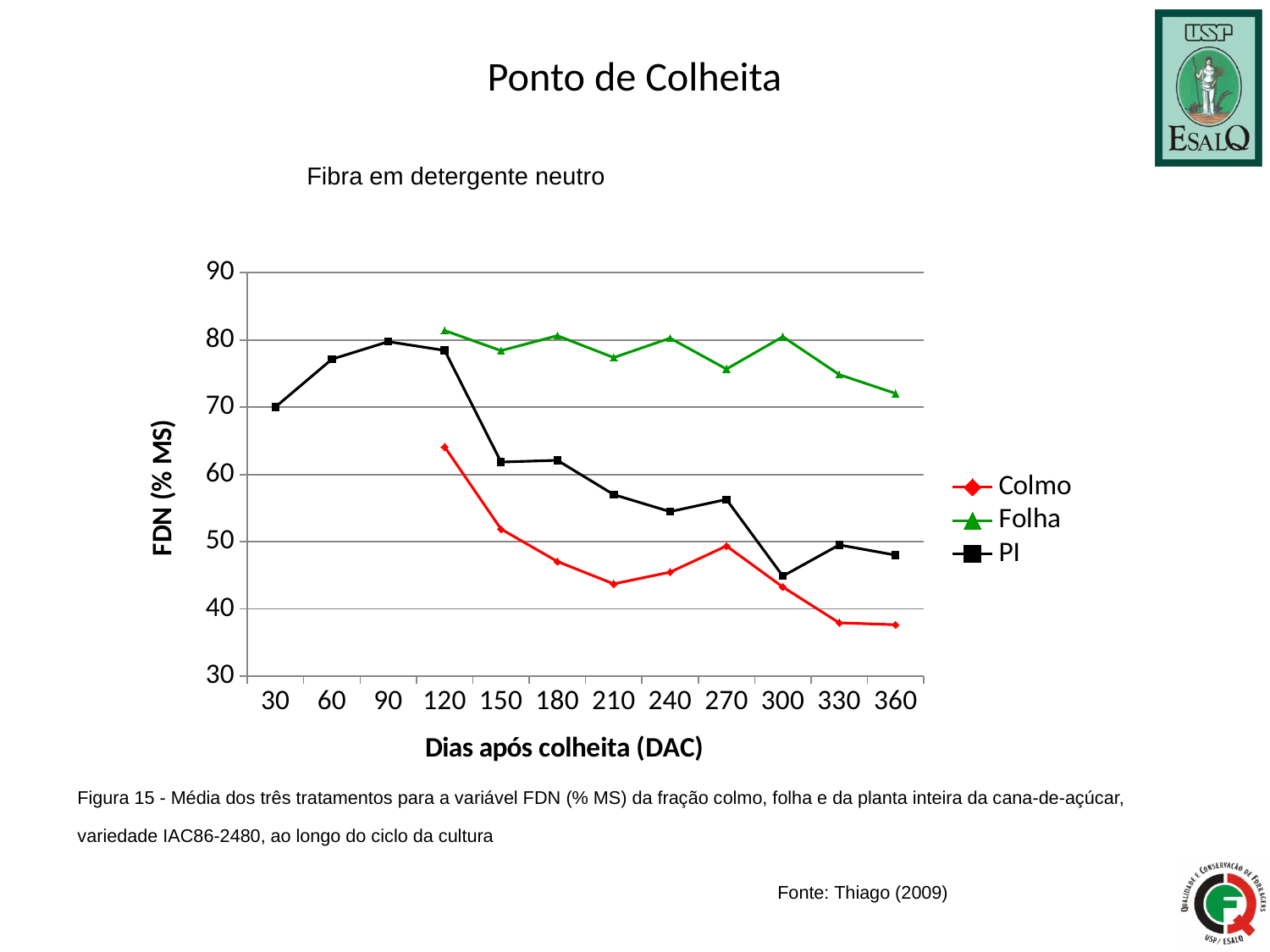
What kind of chart is shown on the slide? line chart Is the value for Colmo at 120 DAC greater or less than 60? greater At 150 DAC, which series has the larger value, Folha or Colmo? Folha Is the value for Colmo at 210 DAC greater or less than 50? less Is the value for Folha at 360 DAC greater or less than 70? greater How many series does the legend list? 3 How many DAC values are shown on the x axis? 12 Does the Colmo series generally rise or fall from 120 DAC to 360 DAC? fall What is the label of the y axis? FDN (% MS) Which series has the highest values across the whole cycle? Folha